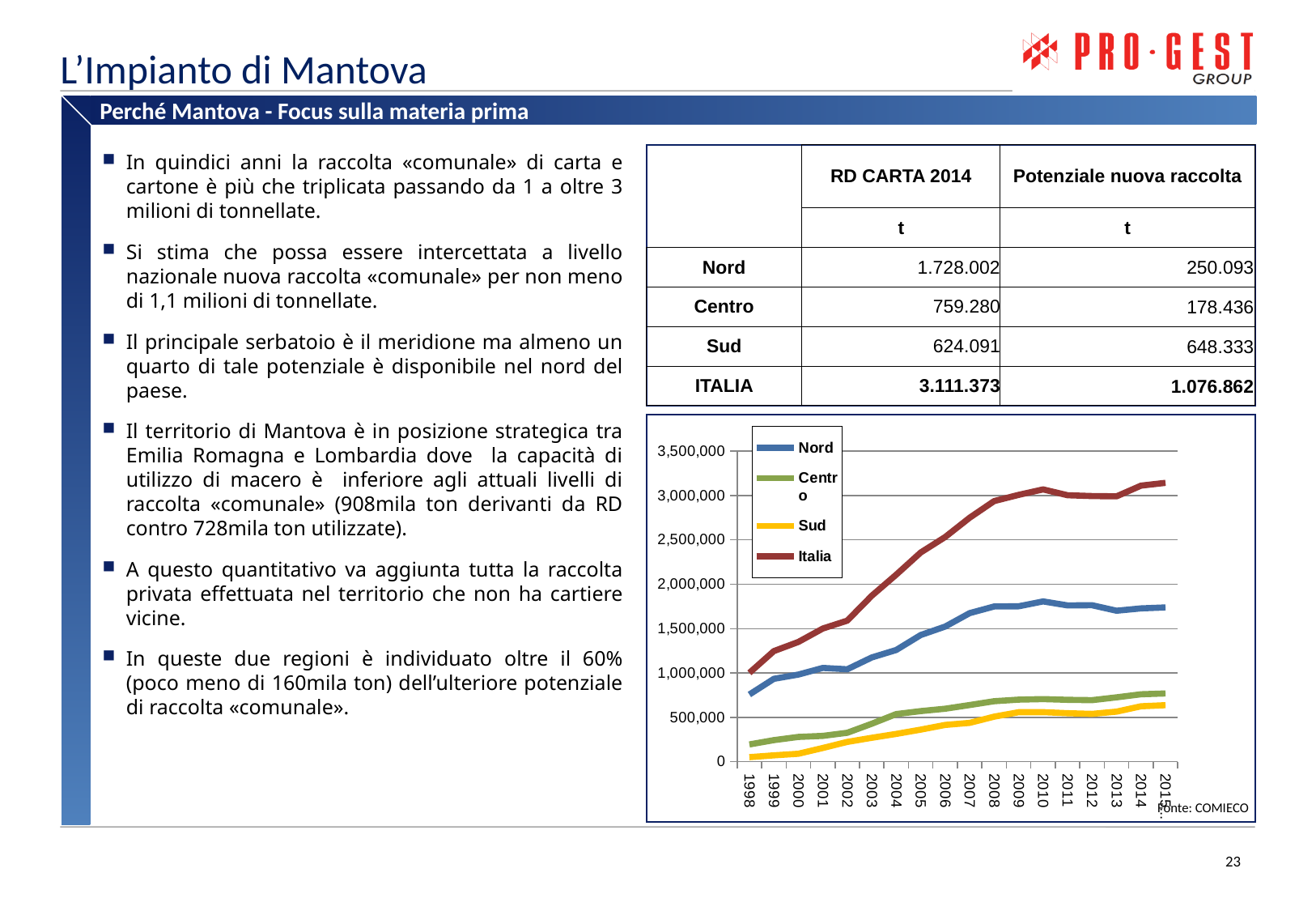
In the line chart, is the value for Centro in 1998 greater or less than 500,000? less Which series in the line chart has the lowest values throughout the period? Sud How many series does the legend of the line chart list? 4 In the line chart, is the value for Italia in 2005 greater or less than 2,000,000? greater In the line chart, is the value for Nord in 2015 greater or less than 1,500,000? greater Does the Italia line rise or fall between 1998 and 2010? rise What colour is the Italia line in the chart? dark red What kind of chart is shown on the slide? line chart How many years are plotted along the x axis of the line chart? 18 Which series in the line chart has the highest values throughout the period? Italia In the line chart, which is larger in 2010: Centro or Sud? Centro